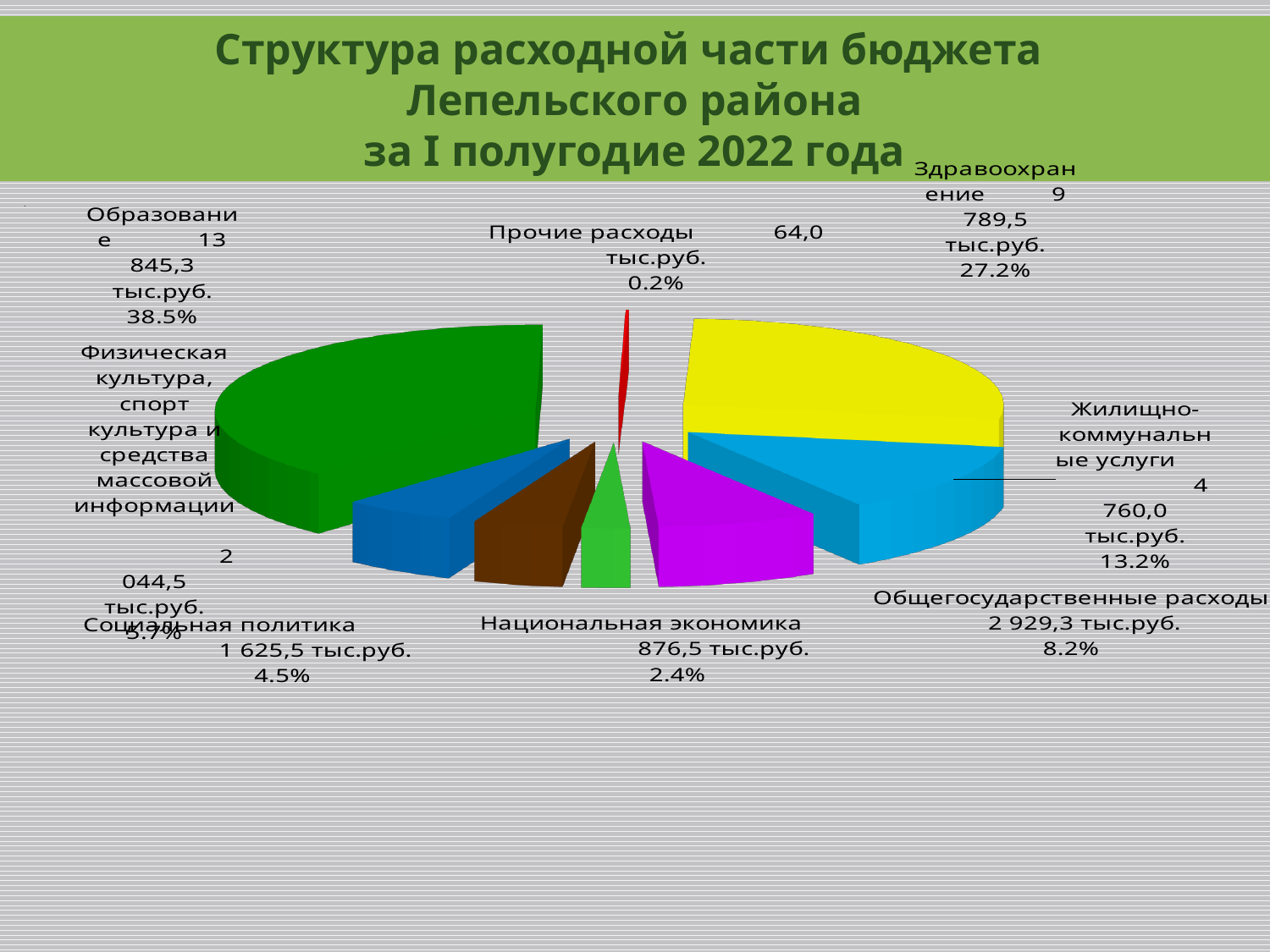
What is the amount shown for Жилищно-коммунальные услуги? 4 760,0 тыс.руб. What is the amount shown for Прочие расходы? 64,0 тыс.руб. Which is larger: the share for Социальная политика or the share for Национальная экономика? Социальная политика What is the difference in percentage points between the shares of Образование and Здравоохранение? 11.3 How many slices does the pie chart have? 8 What is the amount shown for Здравоохранение? 9 789,5 тыс.руб. What share of the budget expenditure goes to Образование? 38.5% What kind of chart is shown on the slide? pie chart What percentage is shown for Общегосударственные расходы? 8.2% Which category has the largest share of the budget expenditure? Образование Which category has the smallest share of the budget expenditure? Прочие расходы What is the title of the chart? Структура расходной части бюджета Лепельского района за I полугодие 2022 года